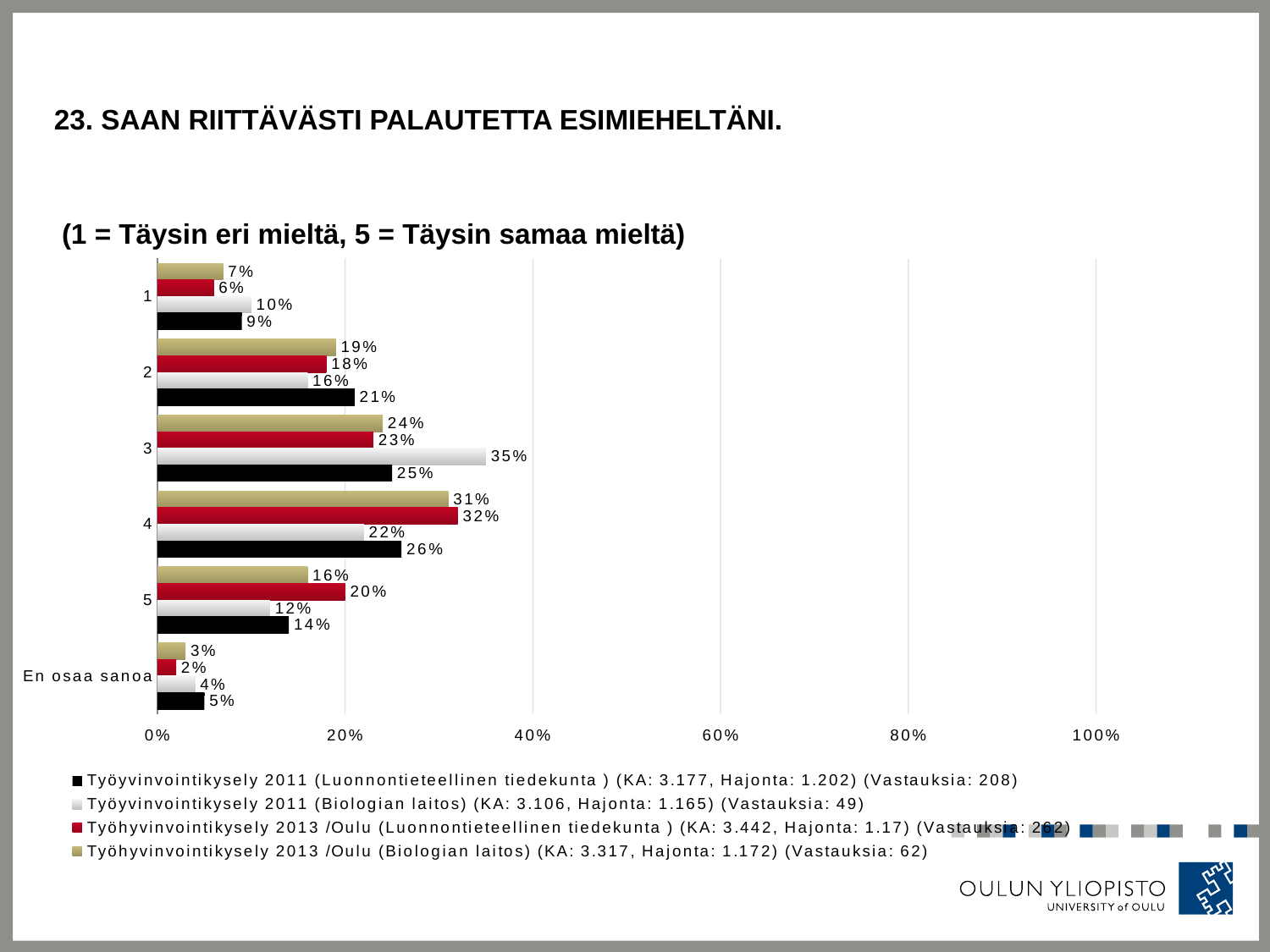
How many categories are shown on the vertical axis of the chart? 6 For category 5, which series has the larger value: Työhyvinvointikysely 2013 /Oulu (Luonnontieteellinen tiedekunta) or Työyvinvointikysely 2011 (Biologian laitos)? Työhyvinvointikysely 2013 /Oulu (Luonnontieteellinen tiedekunta) What type of chart is shown on the slide? bar chart What is the value for category 4 in the Työhyvinvointikysely 2013 /Oulu (Luonnontieteellinen tiedekunta) series? 32% What is the difference between the Työyvinvointikysely 2011 (Biologian laitos) value and the Työhyvinvointikysely 2013 /Oulu (Biologian laitos) value for category 3? 11% How many series does the legend list? 4 Is the value for category 3 in the Työyvinvointikysely 2011 (Biologian laitos) series greater or less than 20%? greater What is the value for 'En osaa sanoa' in the Työyvinvointikysely 2011 (Luonnontieteellinen tiedekunta) series? 5% What is the title of the slide containing the chart? 23. SAAN RIITTÄVÄSTI PALAUTETTA ESIMIEHELTÄNI. What is the value for category 3 in the Työyvinvointikysely 2011 (Biologian laitos) series? 35% Which category has the highest value in the Työhyvinvointikysely 2013 /Oulu (Biologian laitos) series? 4 Which category has the lowest value in the Työhyvinvointikysely 2013 /Oulu (Luonnontieteellinen tiedekunta) series? En osaa sanoa